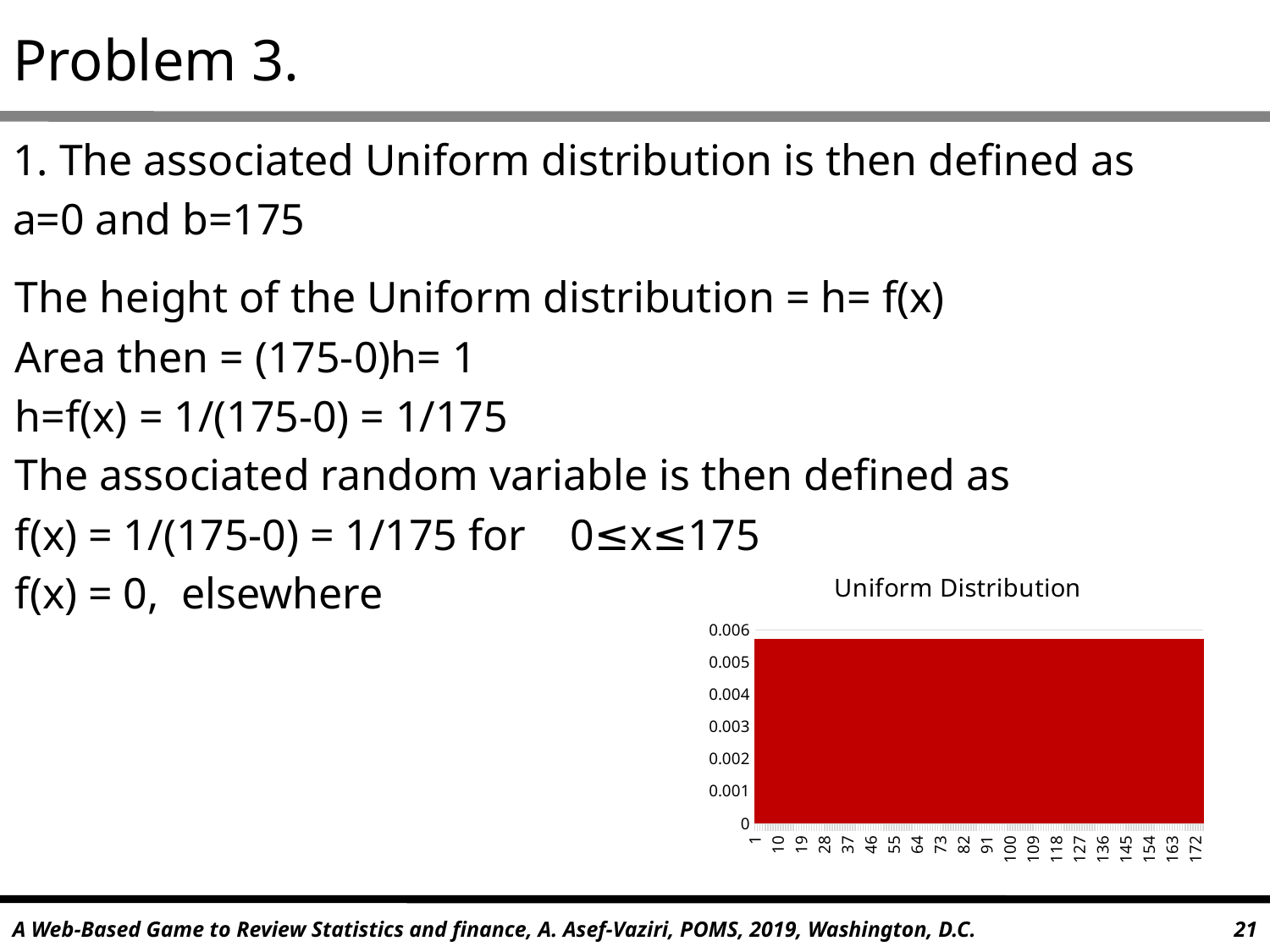
What is the title of the chart on the slide? Uniform Distribution What is the last tick label shown on the x axis of the chart? 172 What is the first tick label shown on the x axis of the chart? 1 Is the value for x=100 greater or less than 0.005? greater Is the value for x=1 greater or less than 0.004? greater What kind of chart is shown on the slide? area chart Do the plotted values rise, fall, or stay flat as x increases along the x axis? stay flat What colour are the bars in the chart? red Is the value for x=172 greater or less than 0.003? greater What is the highest tick value shown on the y axis of the chart? 0.006